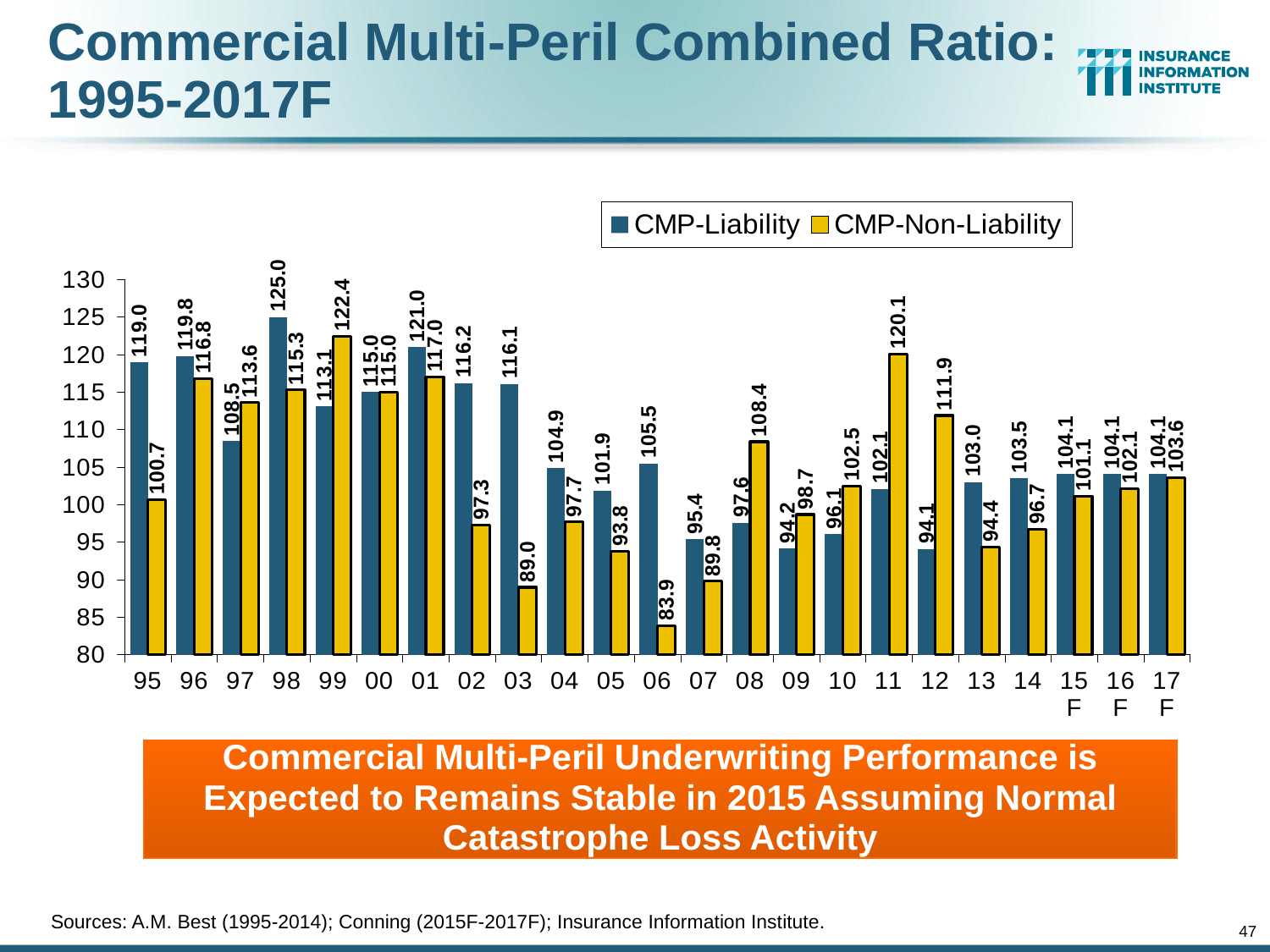
What is the CMP-Liability combined ratio for 1998? 125.0 What kind of chart is shown on the slide? Bar chart How many years are shown on the x axis of the chart? 23 Is the CMP-Non-Liability combined ratio for 1999 greater or less than 120? greater How many series does the legend list? 2 What is the CMP-Liability combined ratio forecast for 2017F? 104.1 In which year is the CMP-Liability combined ratio highest? 98 What is the CMP-Non-Liability combined ratio for 2011? 120.1 What is the difference between the CMP-Non-Liability and CMP-Liability combined ratios in 2012? 17.8 In which year is the CMP-Non-Liability combined ratio lowest? 06 What is the CMP-Non-Liability combined ratio for 2006? 83.9 In 2003, which series has the higher combined ratio, CMP-Liability or CMP-Non-Liability? CMP-Liability